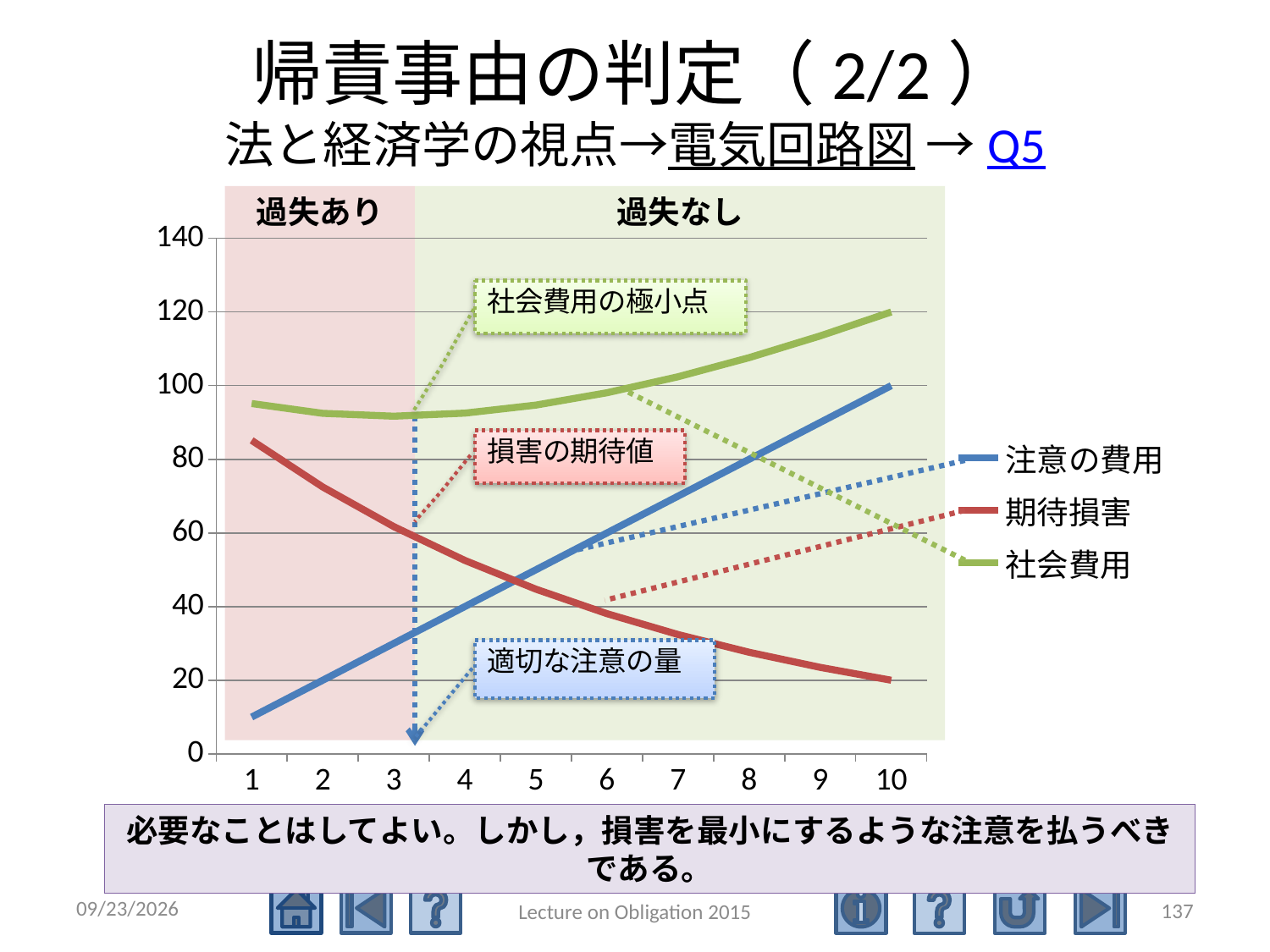
At x = 10, which is larger: 注意の費用 or 期待損害? 注意の費用 Is the value of 注意の費用 at x = 1 greater or less than 20? less Is the value of 期待損害 at x = 1 greater or less than 80? greater What kind of chart is shown on the slide? line chart Does the 注意の費用 line rise or fall as the x axis goes from 1 to 10? rise What label is shown above the red shaded region on the left of the chart? 過失あり How many points are marked along the x axis? 10 What colour is the 社会費用 line in the legend? green Is the value of 社会費用 at x = 10 greater or less than 100? greater At x = 1, which is larger: 社会費用 or 注意の費用? 社会費用 Does the 期待損害 line rise or fall as the x axis goes from 1 to 10? fall How many series does the legend list? 3